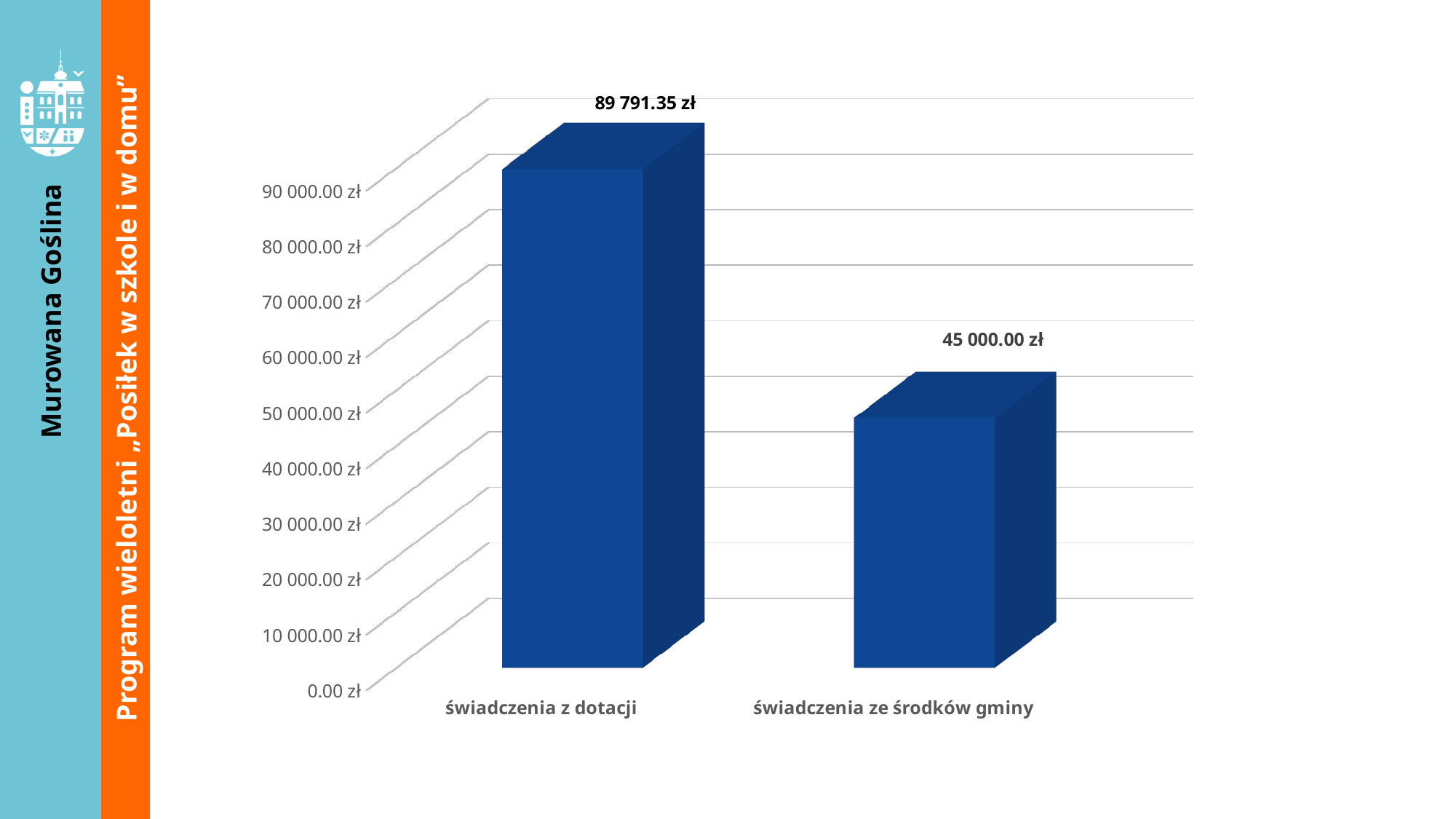
What is the highest value labelled on the vertical axis? 90 000.00 zł Which category has the lowest value? świadczenia ze środków gminy Which category has the highest value? świadczenia z dotacji Which is larger, the value for świadczenia z dotacji or the value for świadczenia ze środków gminy? świadczenia z dotacji What is the value for świadczenia z dotacji? 89 791.35 zł What is the value for świadczenia ze środków gminy? 45 000.00 zł How many categories are shown in the chart? 2 What is the difference between the value for świadczenia z dotacji and the value for świadczenia ze środków gminy? 44 791.35 zł Is the value for świadczenia ze środków gminy greater or less than 50 000.00 zł? less Is the value for świadczenia z dotacji greater or less than 80 000.00 zł? greater What kind of chart is shown on the slide? bar chart What colour are the bars in the chart? blue